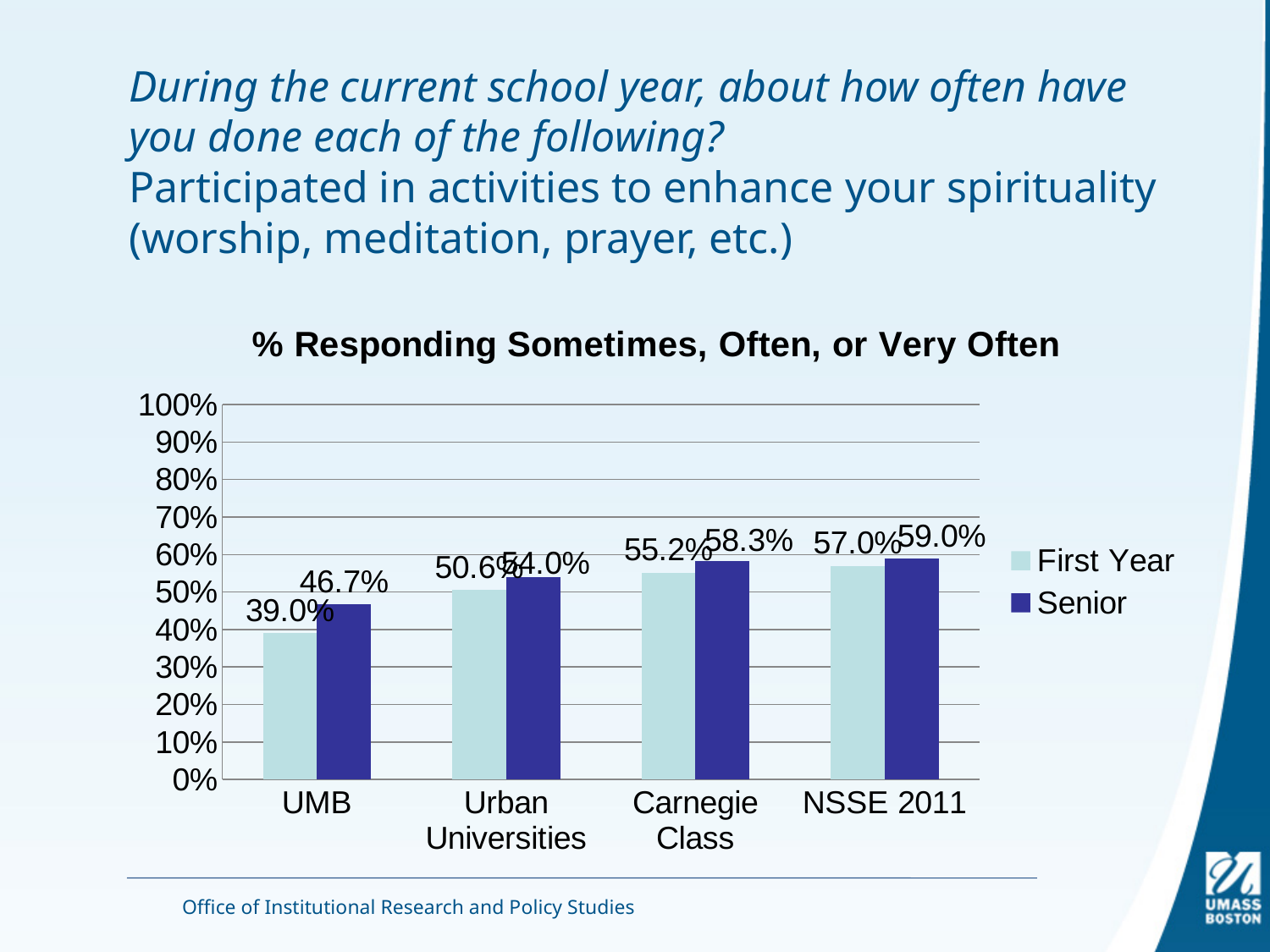
What is the Senior value for Carnegie Class? 58.3% Which category has the lowest First Year value? UMB What is the difference between the Senior and First Year values for UMB? 7.7% Which category has the highest Senior value? NSSE 2011 What kind of chart is shown on the slide? bar chart Is the First Year value for UMB greater or less than 40%? less Which is larger, the First Year value for Urban Universities or the First Year value for Carnegie Class? Carnegie Class What is the First Year value for NSSE 2011? 57.0% What is the First Year value for UMB? 39.0% What is the Senior value for UMB? 46.7% How many series does the legend list? 2 How many categories are shown on the x axis? 4